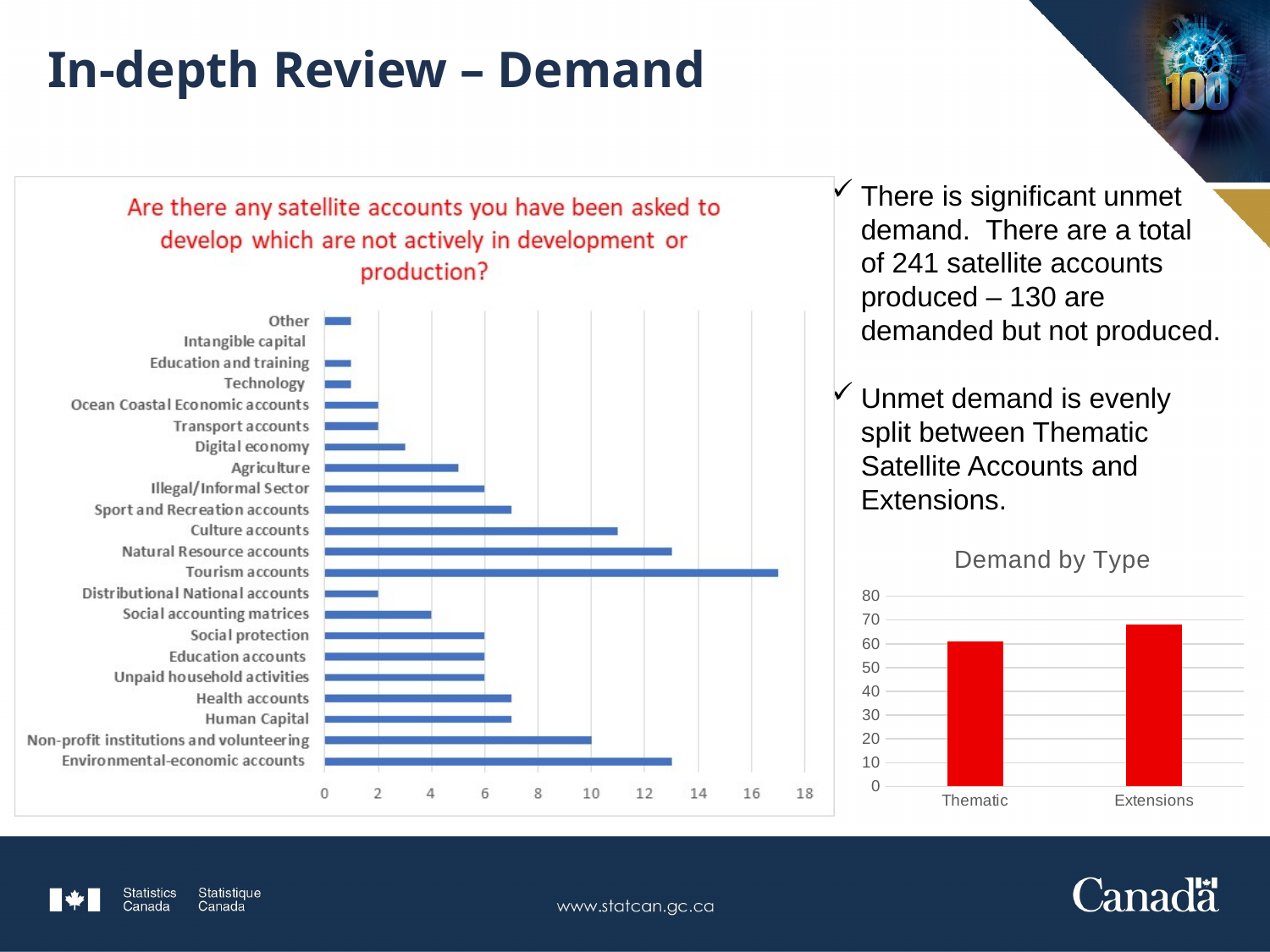
What type of chart is the Demand by Type chart? Bar chart In the left chart, is the value for Culture accounts greater or less than 10? greater How many categories are listed in the left chart? 22 In the left chart, which is larger, Natural Resource accounts or Agriculture? Natural Resource accounts In the left chart, what is the value for Non-profit institutions and volunteering? 10 In the left chart, which category has the longest bar? Tourism accounts In the left chart, which category has no visible bar (the lowest value)? Intangible capital In the Demand by Type chart, is the value for Extensions greater or less than 60? greater In the left chart, is the value for Tourism accounts greater or less than 16? greater In the left chart, what is the value for Transport accounts? 2 In the Demand by Type chart, which category has the higher value, Thematic or Extensions? Extensions In the left chart, what is the value for Social accounting matrices? 4